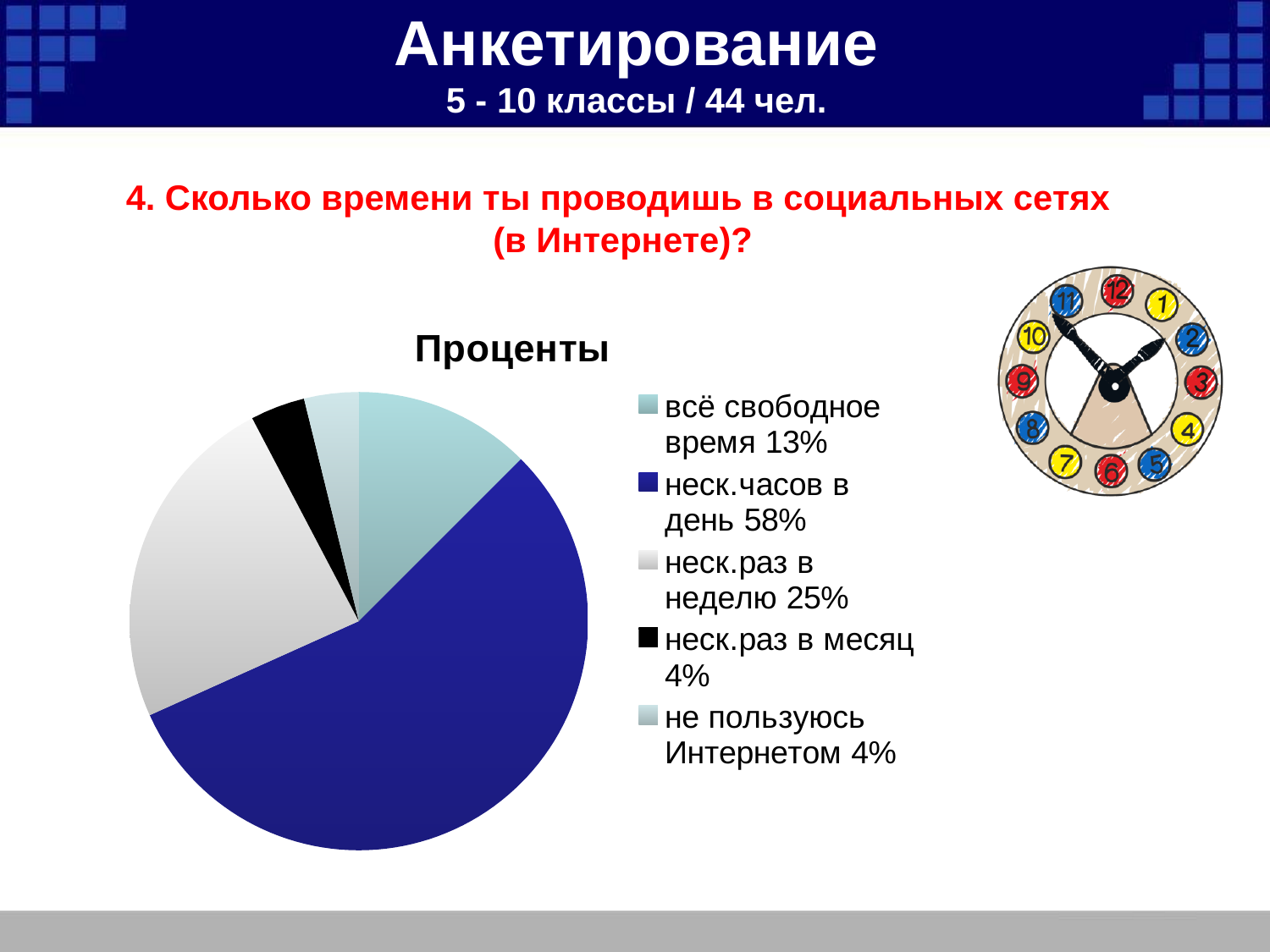
What percentage is shown for "всё свободное время"? 13% What colour is the slice for "неск.часов в день"? dark blue Which category has the largest share of the pie? неск.часов в день What is the difference in percentage points between "неск.часов в день" and "неск.раз в неделю"? 33 What percentage is shown for "неск.часов в день"? 58% What percentage is shown for "не пользуюсь Интернетом"? 4% What is the title of the chart? Проценты What percentage is shown for "неск.раз в неделю"? 25% Which is larger: the share for "всё свободное время" or for "неск.раз в неделю"? неск.раз в неделю How many slices does the pie chart have? 5 What share of the pie does "неск.раз в месяц" take? 4% What kind of chart is shown on the slide? pie chart